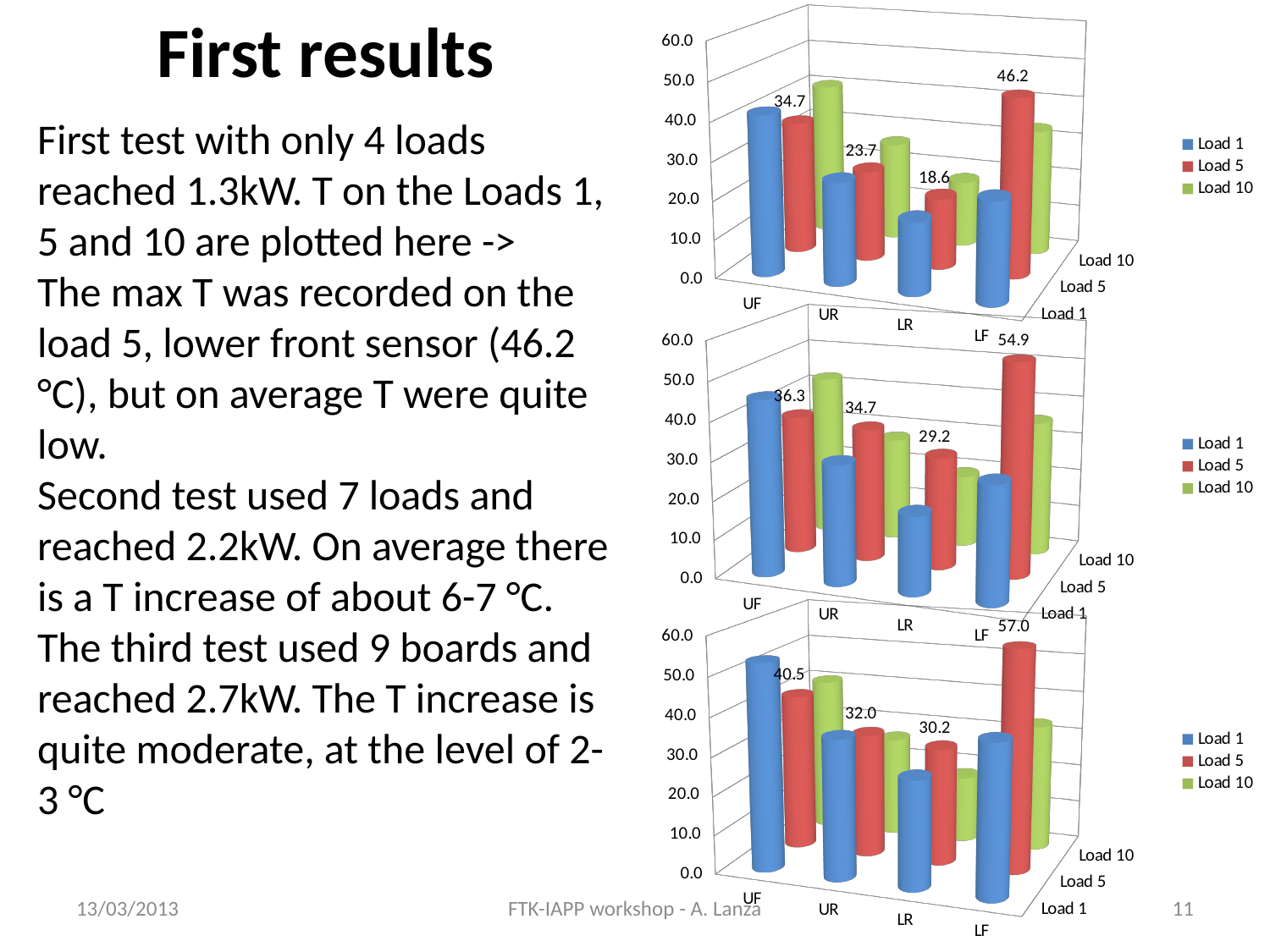
In the top chart, which category has the highest Load 5 value? LF In the bottom chart, what is the value for Load 5 at LF? 57.0 In the top chart, is the value for Load 1 at UF greater or less than 30? greater In the top chart, what is the value for Load 5 at LF? 46.2 In the middle chart, which is larger: the Load 5 value at UF or at UR? UF What kind of chart is the bottom chart? bar chart In the bottom chart, what is the value for Load 5 at UF? 40.5 In the top chart, what is the value for Load 5 at LR? 18.6 How many series does the legend of the middle chart list? 3 In the middle chart, what is the value for Load 5 at LF? 54.9 In the bottom chart, what is the difference between the Load 5 values at LF and LR? 26.8 In the top chart, which category has the lowest Load 5 value? LR